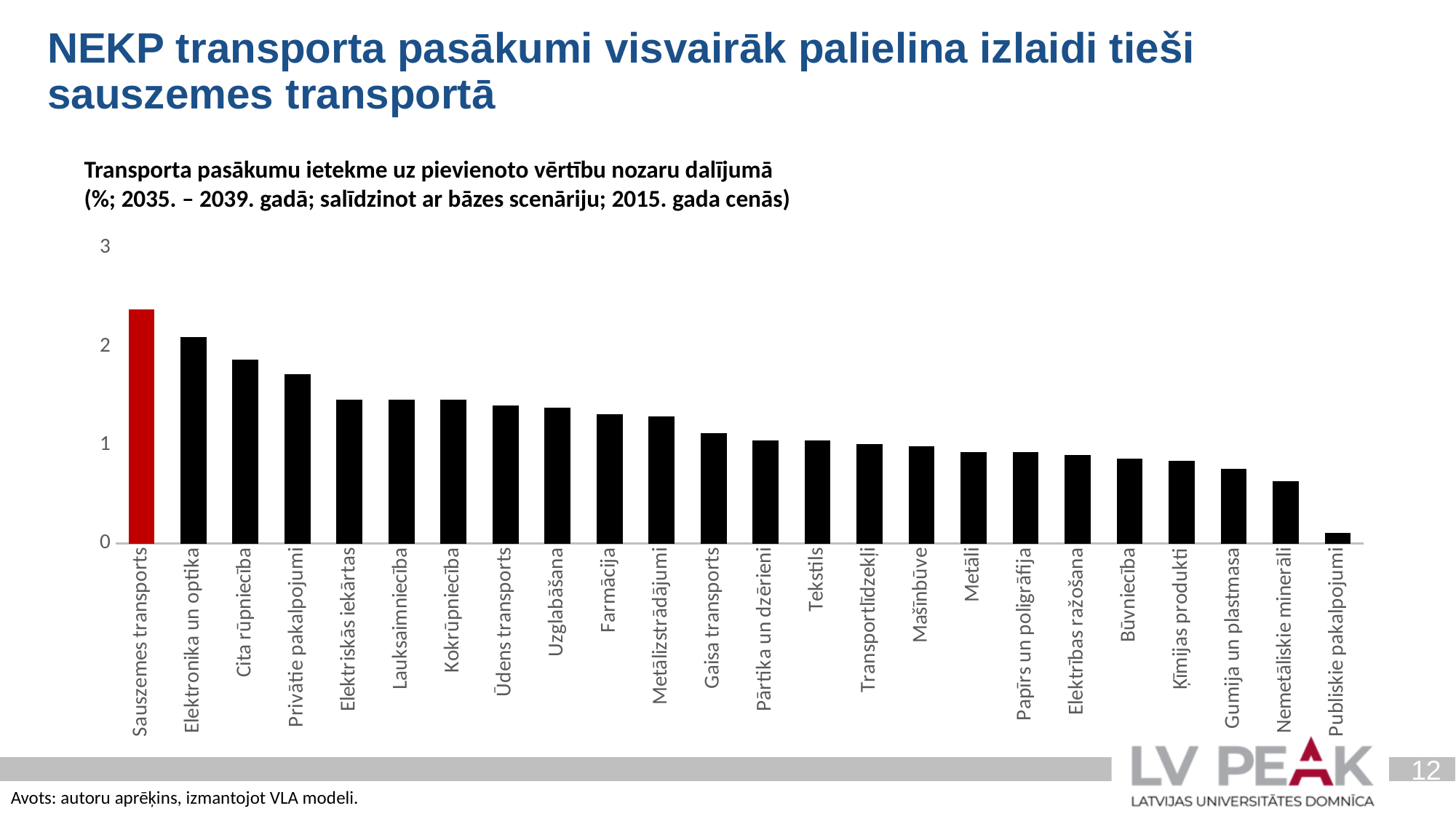
How many sectors (bars) are shown in the chart? 24 Is the value for Cita rūpniecība greater or less than 2? less What kind of chart is shown on the slide? bar chart Which is larger, the value for Sauszemes transports or the value for Elektronika un optika? Sauszemes transports Is the value for Sauszemes transports greater or less than 2? greater Which sector has the lowest value in the chart? Publiskie pakalpojumi Which sector has the highest value in the chart? Sauszemes transports Is the value for Publiskie pakalpojumi greater or less than 1? less Do the bar values rise or fall from left to right along the x axis? fall Which bar is highlighted in red in the chart? Sauszemes transports